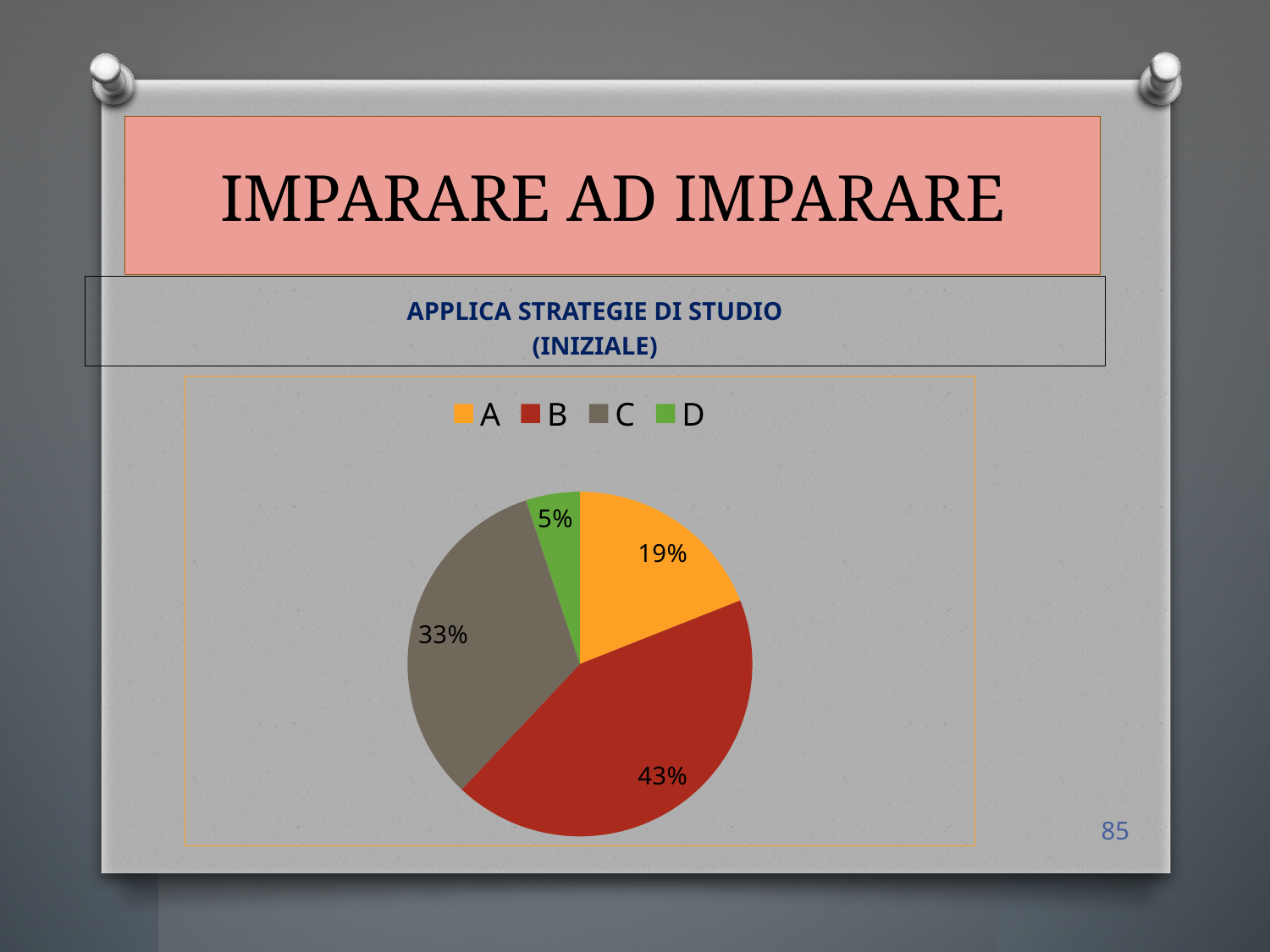
What percentage does slice A represent? 19% What percentage does slice B represent? 43% Which category has the smallest share of the pie? D How many slices does the pie chart have? 4 Which is larger, the share for A or the share for C? C What percentage does slice C represent? 33% What is the difference in percentage points between B and C? 10 What colour is the slice for category B? red How many entries does the legend list? 4 What percentage does slice D represent? 5% What kind of chart is shown on the slide? pie chart Which category has the largest share of the pie? B